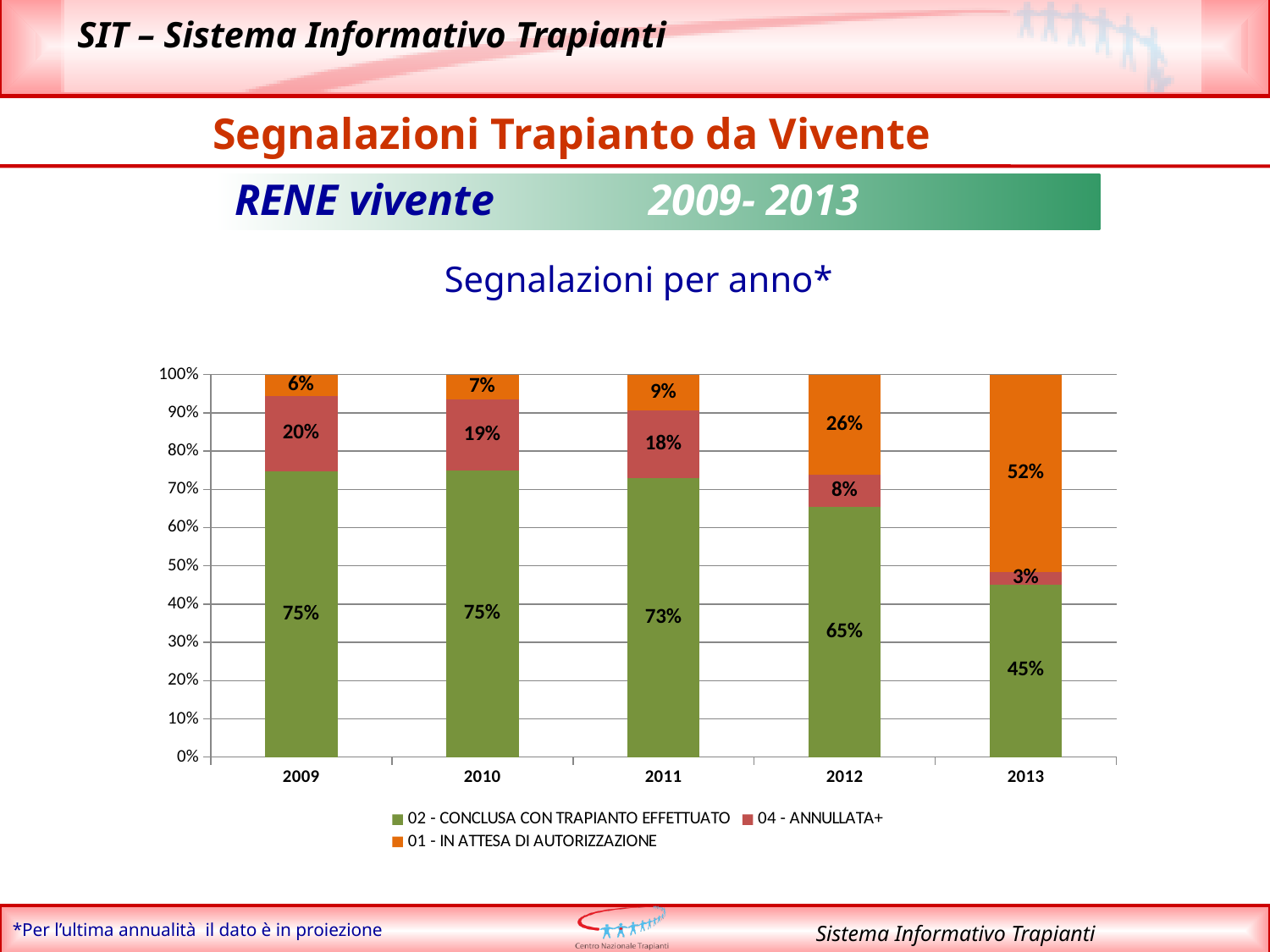
What is the value for "04 - ANNULLATA+" in 2010? 19% What is the value for "01 - IN ATTESA DI AUTORIZZAZIONE" in 2012? 26% What is the title of the chart on the slide? Segnalazioni per anno* How many years are shown on the x axis of the chart? 5 What is the value for "02 - CONCLUSA CON TRAPIANTO EFFETTUATO" in 2013? 45% How many series does the chart legend list? 3 Does the value for "02 - CONCLUSA CON TRAPIANTO EFFETTUATO" rise or fall from 2009 to 2013? Fall In which year is the value for "01 - IN ATTESA DI AUTORIZZAZIONE" highest? 2013 What is the difference between the "02 - CONCLUSA CON TRAPIANTO EFFETTUATO" values for 2009 and 2013? 30% Which is larger in 2012: the value for "02 - CONCLUSA CON TRAPIANTO EFFETTUATO" or the value for "01 - IN ATTESA DI AUTORIZZAZIONE"? 02 - CONCLUSA CON TRAPIANTO EFFETTUATO What kind of chart is shown on the slide? Stacked bar chart In which year is the value for "04 - ANNULLATA+" lowest? 2013